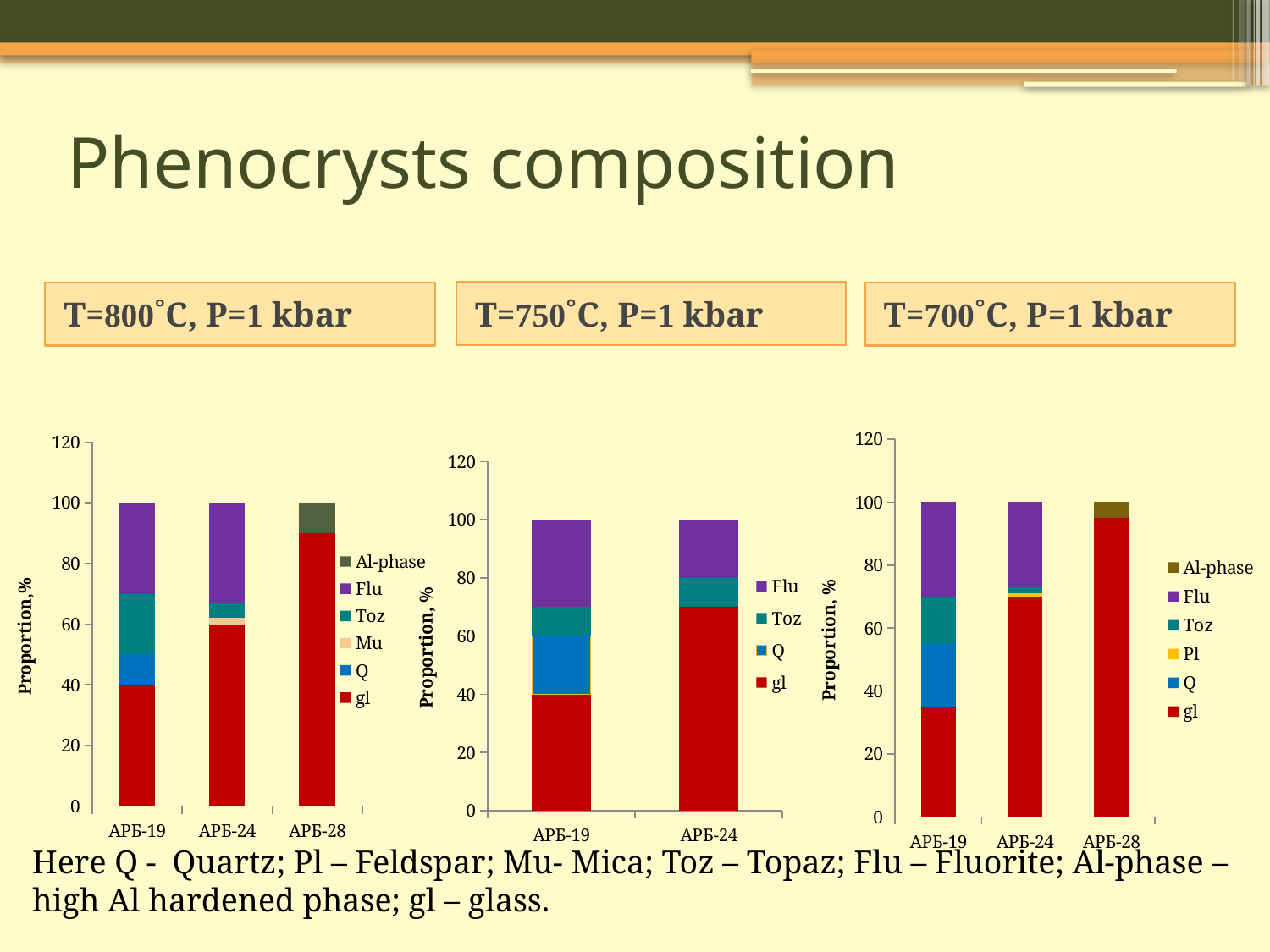
What kind of chart is shown under T=800˚C, P=1 kbar? stacked bar chart How many series does the legend of the T=700˚C, P=1 kbar chart list? 6 How many series does the legend of the T=750˚C, P=1 kbar chart list? 4 How many series does the legend of the T=800˚C, P=1 kbar chart list? 6 In the T=750˚C, P=1 kbar chart, is the gl value for АРБ-24 greater or less than 60? greater What is the y-axis title of the T=750˚C, P=1 kbar chart? Proportion, % In the T=700˚C, P=1 kbar chart, which category has the largest gl segment? АРБ-28 How many categories are plotted on the x axis of the T=800˚C, P=1 kbar chart? 3 In the T=700˚C, P=1 kbar chart, is the gl value for АРБ-19 greater or less than 40? less In the T=800˚C, P=1 kbar chart, which has the larger gl value, АРБ-19 or АРБ-28? АРБ-28 How many categories are plotted on the x axis of the T=750˚C, P=1 kbar chart? 2 In the T=800˚C, P=1 kbar chart, is the gl value for АРБ-28 greater or less than 80? greater